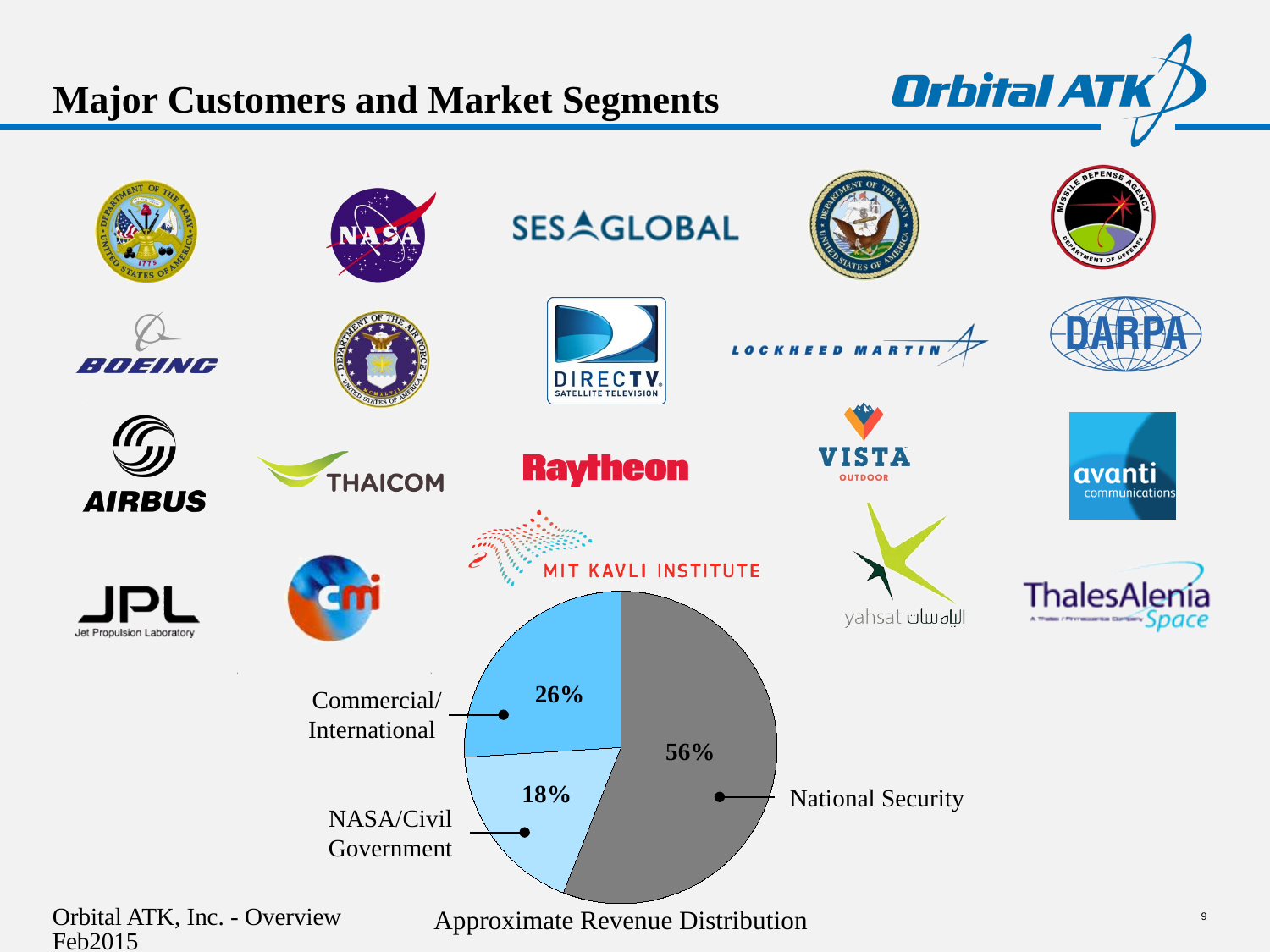
What share of revenue does National Security account for? 56% What colour is the National Security slice? gray What kind of chart is shown on the slide? pie chart Which is larger, the Commercial/International share or the NASA/Civil Government share? Commercial/International What is the caption below the pie chart? Approximate Revenue Distribution What is the difference in percentage points between Commercial/International and NASA/Civil Government? 8 How many segments does the pie chart show? 3 What share of revenue does Commercial/International account for? 26% What is the difference in percentage points between National Security and Commercial/International? 30 Which segment has the smallest share of revenue? NASA/Civil Government Which segment has the largest share of revenue? National Security What share of revenue does NASA/Civil Government account for? 18%